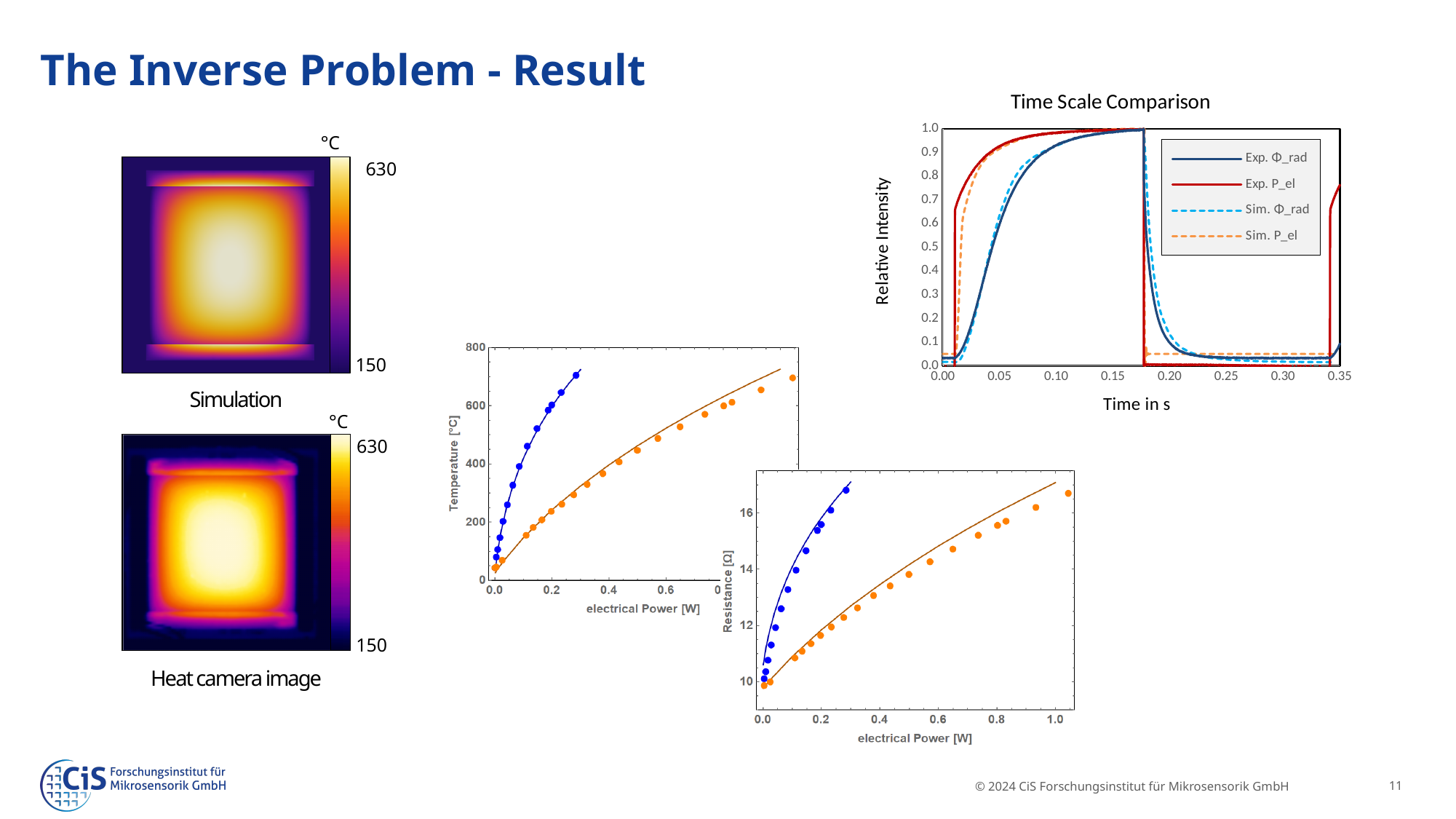
In the Resistance [Ω] versus electrical Power [W] chart, is the blue series value at 0.2 W greater or less than 14? greater How many series does the legend of the Time Scale Comparison chart list? 4 In the Temperature [°C] versus electrical Power [W] chart, is the blue series value at 0.2 W greater or less than 400? greater In the Temperature [°C] versus electrical Power [W] chart, which series is higher at 0.2 W, the blue or the orange one? blue What kind of chart is the Time Scale Comparison chart? line chart In the Temperature [°C] versus electrical Power [W] chart, is the orange series value at 0.2 W greater or less than 400? less In the Time Scale Comparison chart, do the Exp. Φ_rad values rise or fall between 0.00 s and 0.15 s? rise In the Time Scale Comparison chart, what is the label of the x axis? Time in s What is the title of the line chart in the top right of the slide? Time Scale Comparison